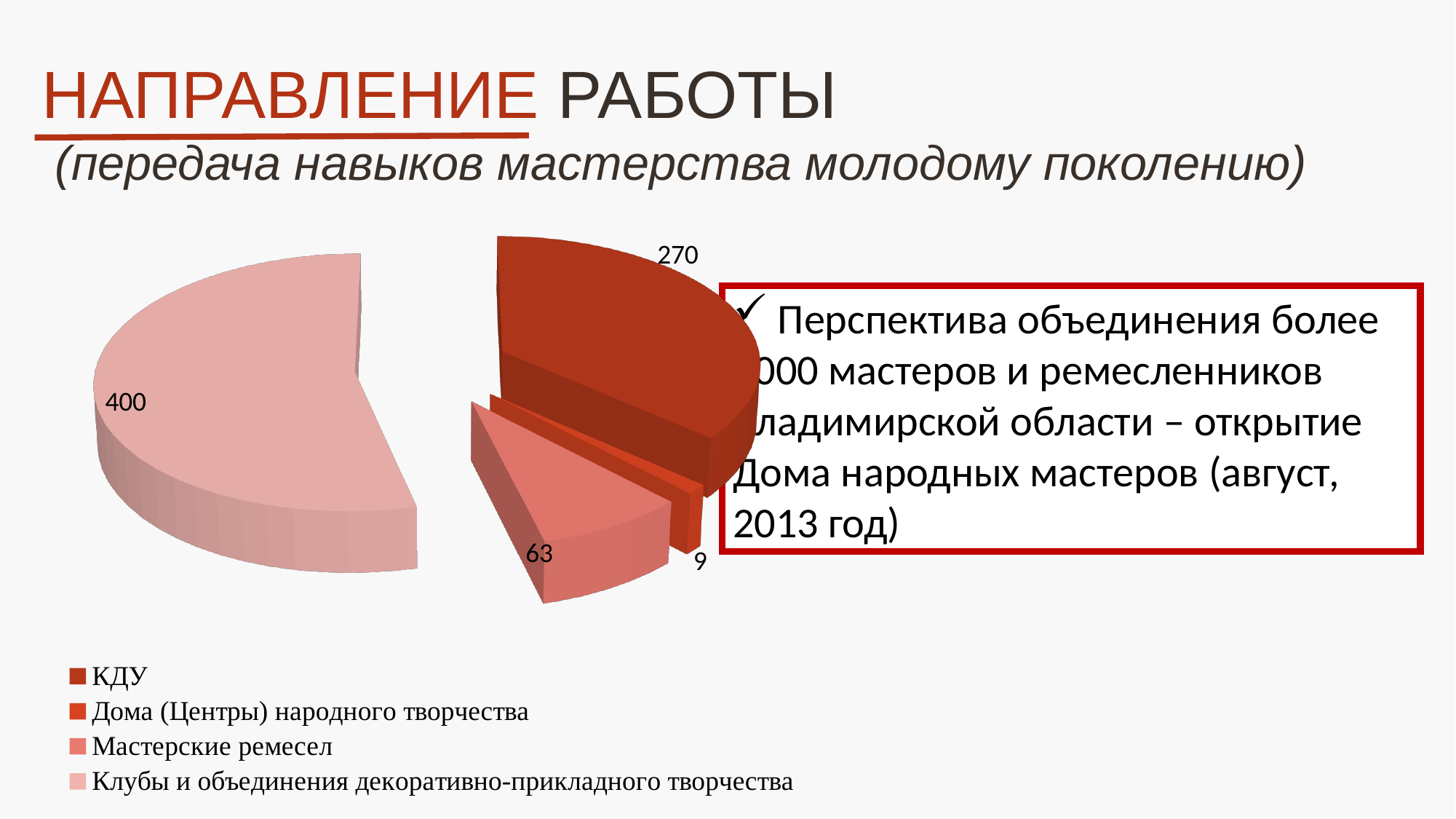
Which is larger: the value for КДУ or the value for Мастерские ремесел? КДУ What type of chart is shown on the slide? pie chart Which category has the largest slice in the pie chart? Клубы и объединения декоративно-прикладного творчества What is the value for КДУ in the pie chart? 270 What is the value for Клубы и объединения декоративно-прикладного творчества? 400 What is the total of all the values shown in the pie chart? 742 What is the value for Мастерские ремесел? 63 What is the difference between the values for Клубы и объединения декоративно-прикладного творчества and КДУ? 130 How many categories does the pie chart have? 4 What is the value for Дома (Центры) народного творчества? 9 What is the difference between the values for Мастерские ремесел and Дома (Центры) народного творчества? 54 Which category has the smallest slice in the pie chart? Дома (Центры) народного творчества